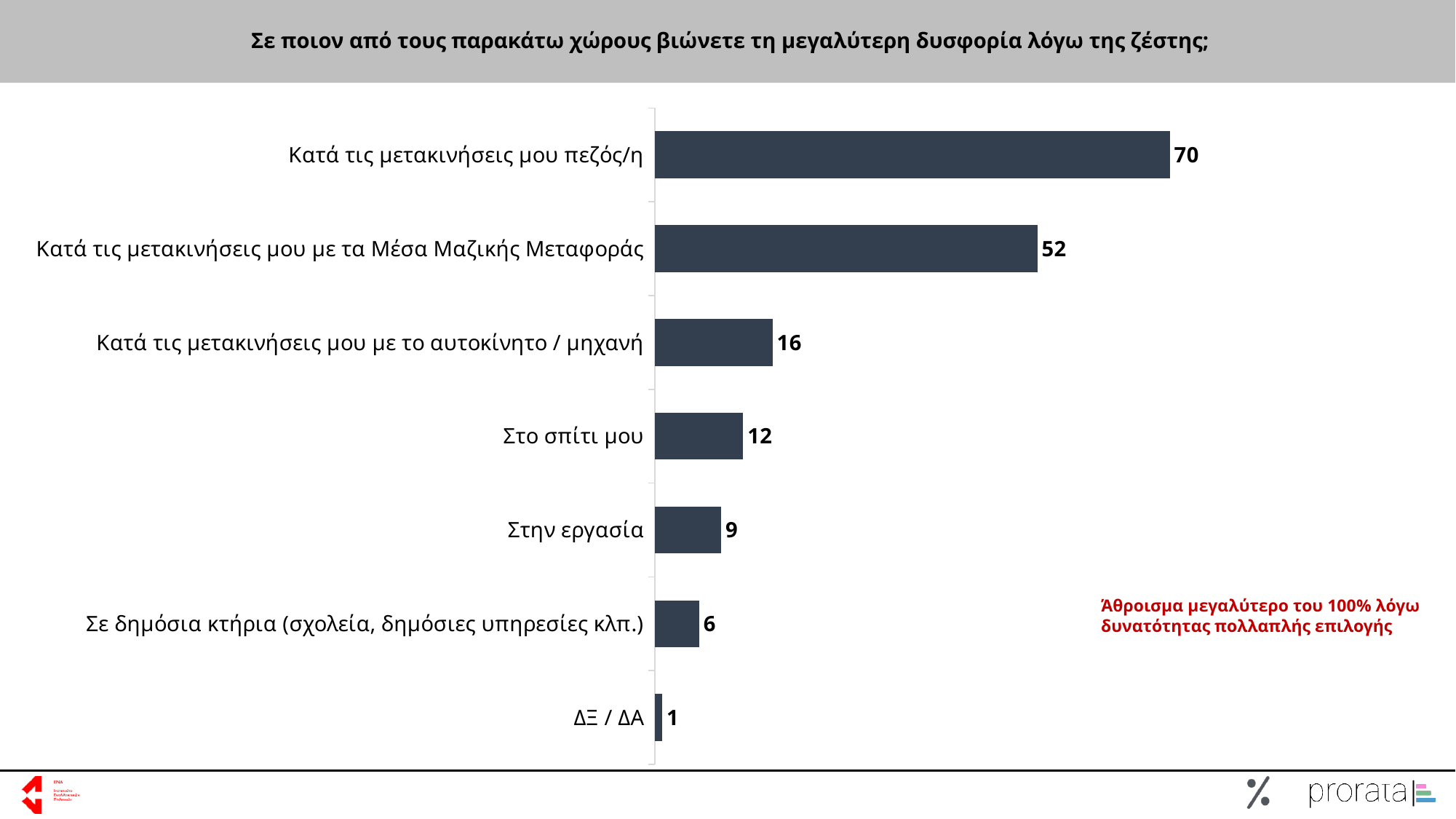
What is the title of the chart? Σε ποιον από τους παρακάτω χώρους βιώνετε τη μεγαλύτερη δυσφορία λόγω της ζέστης; How many categories are shown in the chart? 7 What is the value for "Στο σπίτι μου"? 12 What is the difference between the values for "Κατά τις μετακινήσεις μου με το αυτοκίνητο / μηχανή" and "Στην εργασία"? 7 Which is larger, the value for "Στο σπίτι μου" or the value for "Στην εργασία"? Στο σπίτι μου What is the value for "Στην εργασία"? 9 Which category has the highest value? Κατά τις μετακινήσεις μου πεζός/η What is the value for "Κατά τις μετακινήσεις μου πεζός/η"? 70 What is the difference between the values for "Κατά τις μετακινήσεις μου πεζός/η" and "Κατά τις μετακινήσεις μου με τα Μέσα Μαζικής Μεταφοράς"? 18 What is the value for "Σε δημόσια κτήρια (σχολεία, δημόσιες υπηρεσίες κλπ.)"? 6 What kind of chart is shown on the slide? Bar chart Which category has the lowest value? ΔΞ / ΔΑ